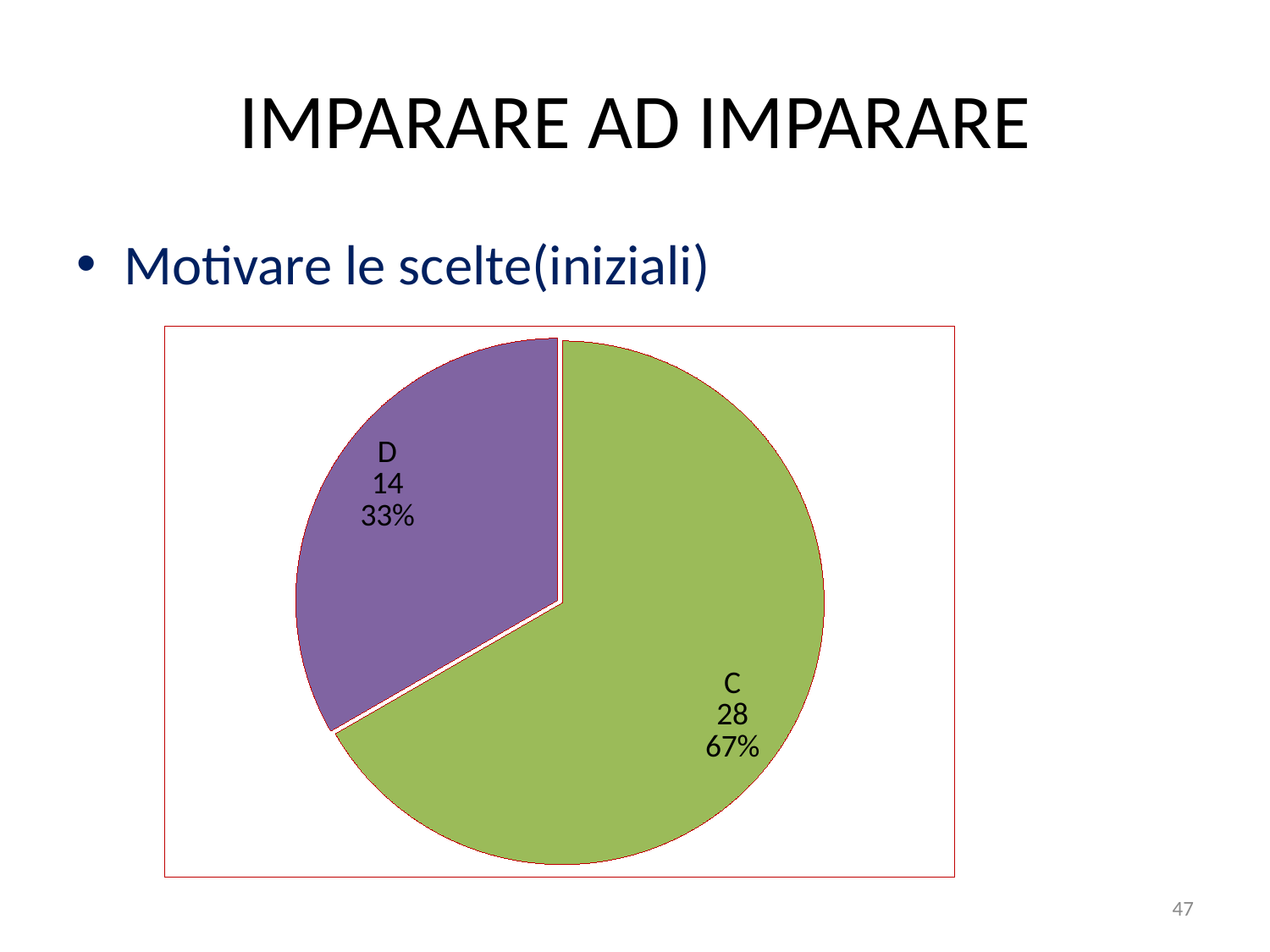
What is the total of the values shown in the pie chart? 42 What share of the pie does slice C represent? 67% How many slices does the pie chart have? 2 What is the difference between the values of C and D? 14 What colour is the slice labelled D? purple Which is larger, the value for C or the value for D? C What share of the pie does slice D represent? 33% Which slice is the smallest? D What is the value for slice C? 28 What kind of chart is shown on the slide? pie chart Which slice is the largest? C What is the value for slice D? 14